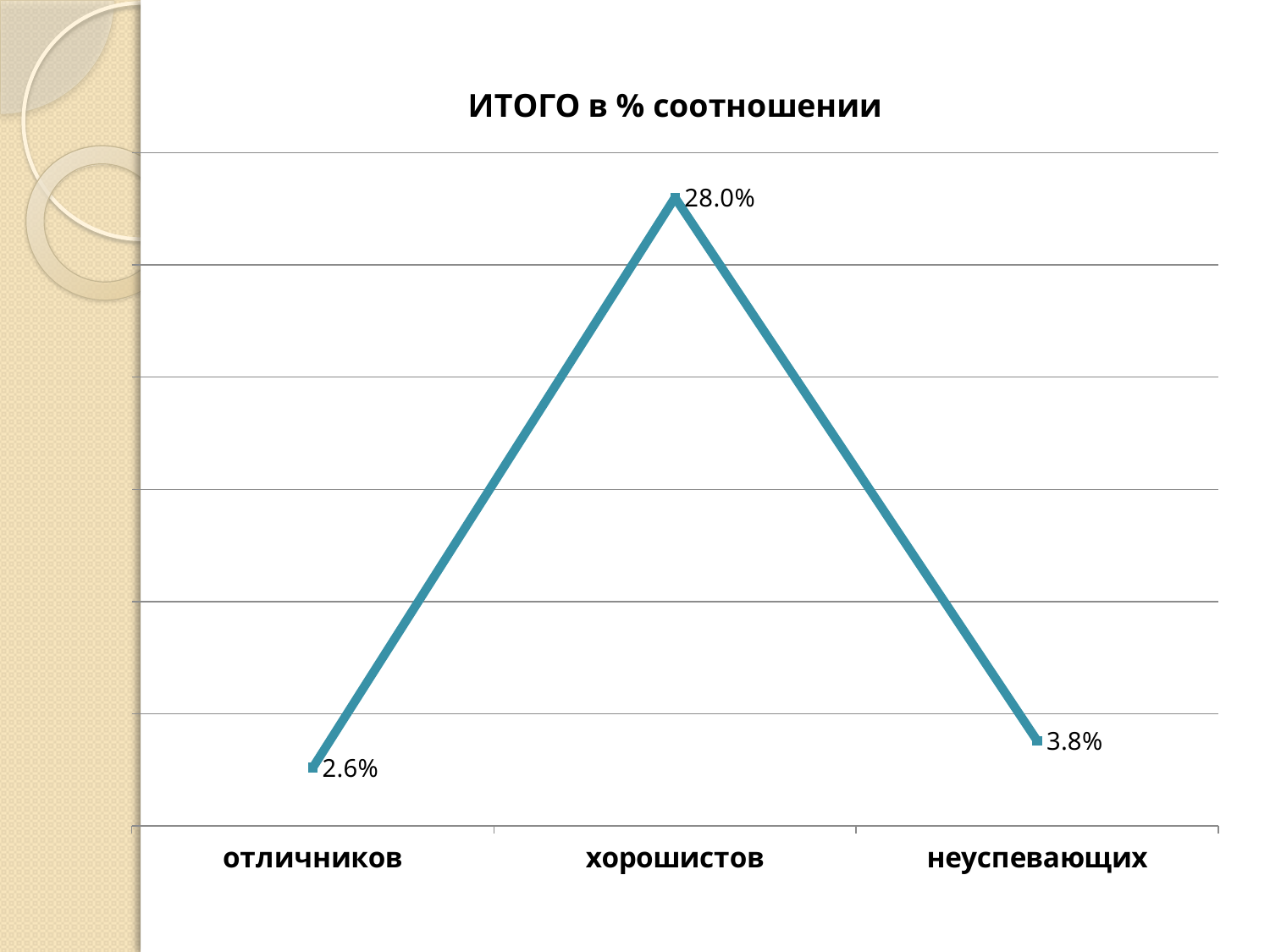
Does the value rise or fall from хорошистов to неуспевающих? fall Which category has the highest value? хорошистов Which category has the lowest value? отличников What is the title of the chart? ИТОГО в % соотношении How many categories are shown on the x axis? 3 What is the value for отличников? 2.6% What is the difference between the values for неуспевающих and отличников? 1.2% What is the value for хорошистов? 28.0% What is the difference between the values for хорошистов and отличников? 25.4% What kind of chart is this? line chart Which is larger, the value for неуспевающих or the value for отличников? неуспевающих What is the value for неуспевающих? 3.8%